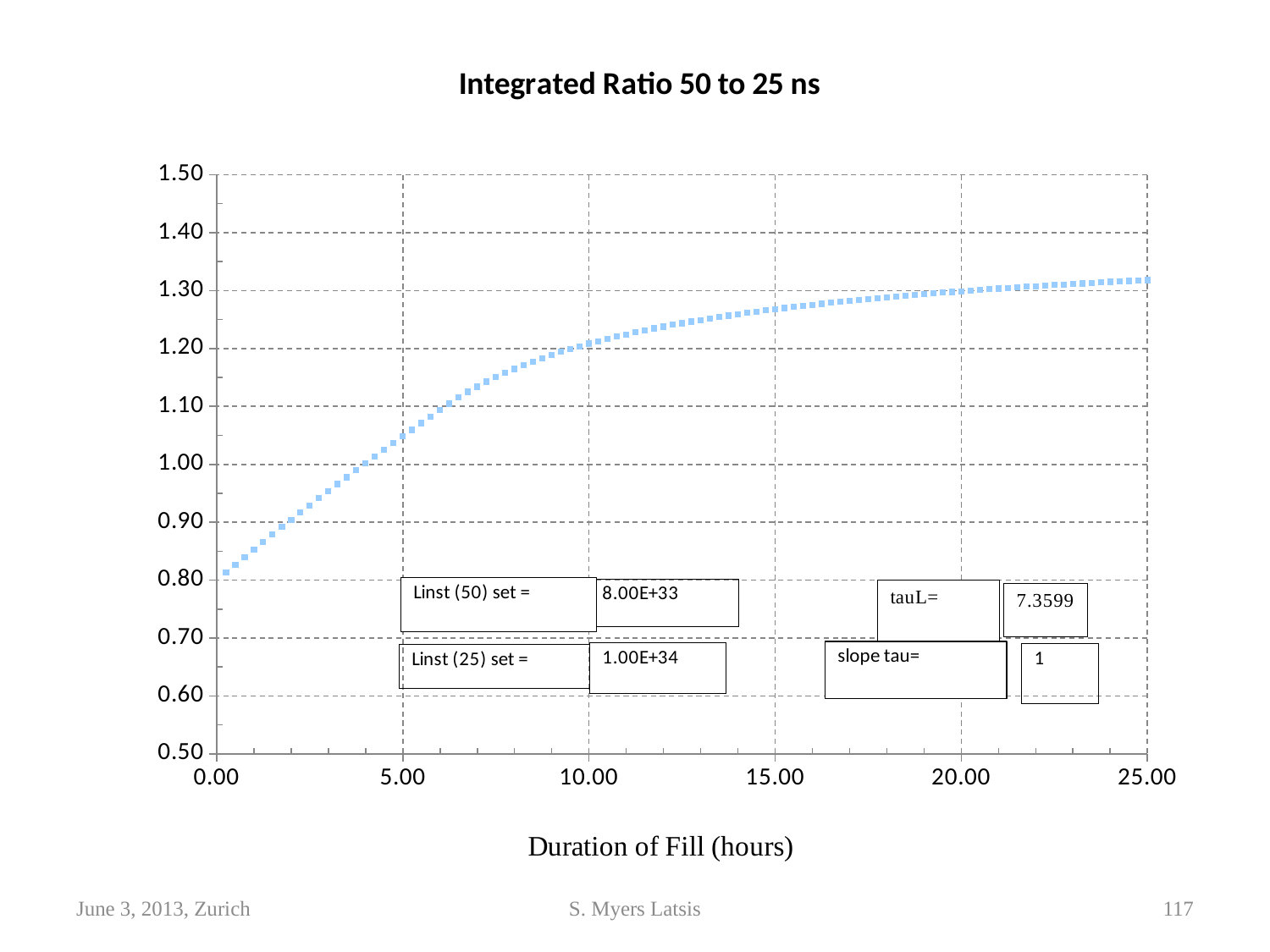
What is the title of the chart? Integrated Ratio 50 to 25 ns Do the plotted values rise or fall as the duration of fill increases? rise Is the value at a duration of 15.00 hours greater or less than 1.20? greater Is the value at the start of the fill (near 0.00 hours) greater or less than 0.90? less What value is shown for tauL in the text box on the chart? 7.3599 Is the value at a duration of 25.00 hours greater or less than 1.40? less What kind of chart is shown on the slide? scatter chart Is the value at 20.00 hours larger or smaller than the value at 5.00 hours? larger